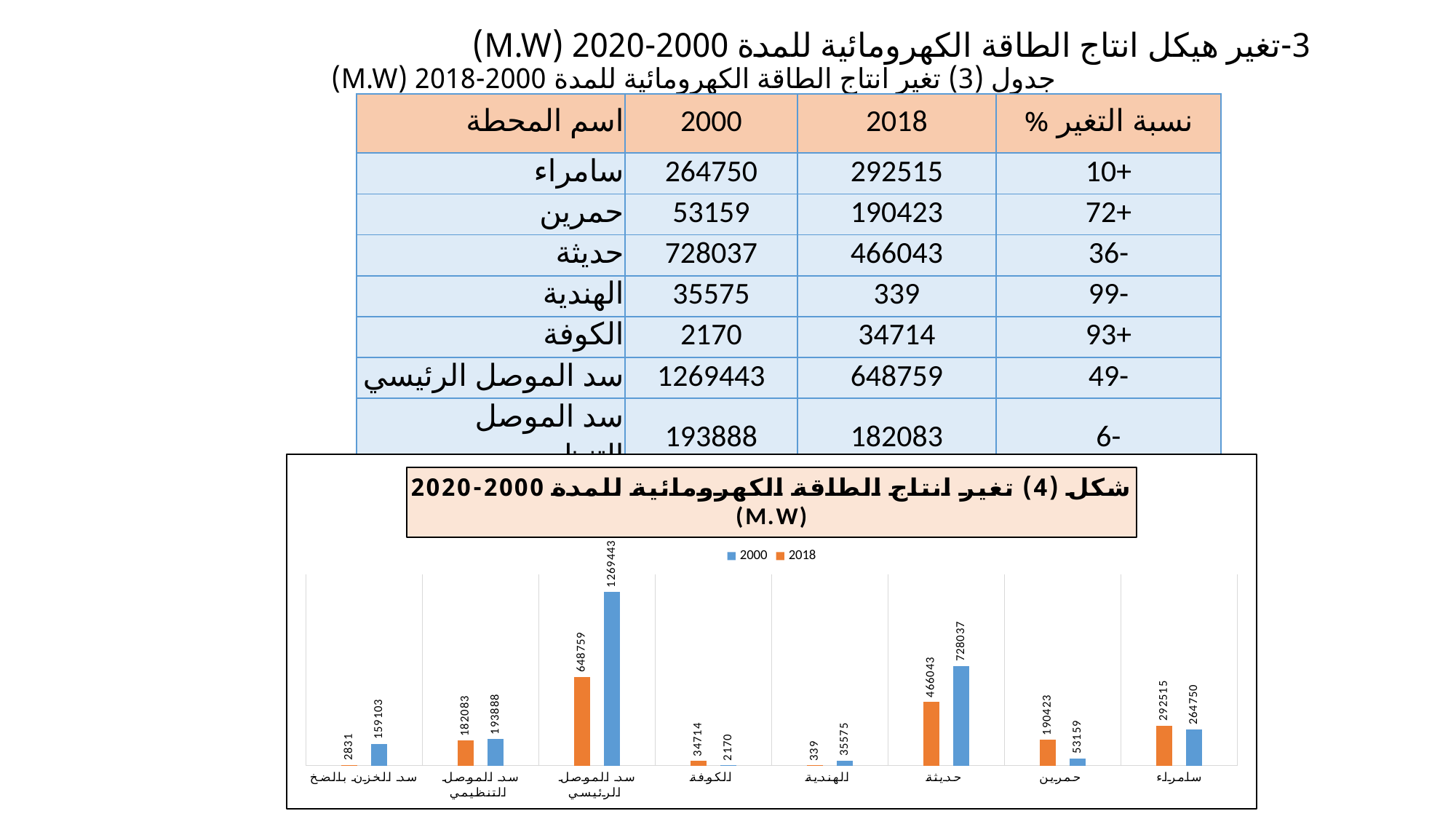
Which station has the highest 2000 value on the chart? سد الموصل الرئيسي What is the 2000 value for سد الموصل الرئيسي on the chart? 1269443 For سامراء, which is larger on the chart: the 2000 value or the 2018 value? 2018 What is the 2018 value for الهندية on the chart? 339 How many series does the legend of the chart list? 2 Which colour represents the 2018 series in the chart? orange What is the difference between the 2000 and 2018 values for حمرين on the chart? 137264 What type of chart is shown in شكل (4)? bar chart How many stations (categories) are plotted on the chart? 8 What is the 2018 value for حديثة on the chart? 466043 Which station has the lowest 2018 value on the chart? الهندية What is the 2000 value for سد الخزن بالضخ on the chart? 159103